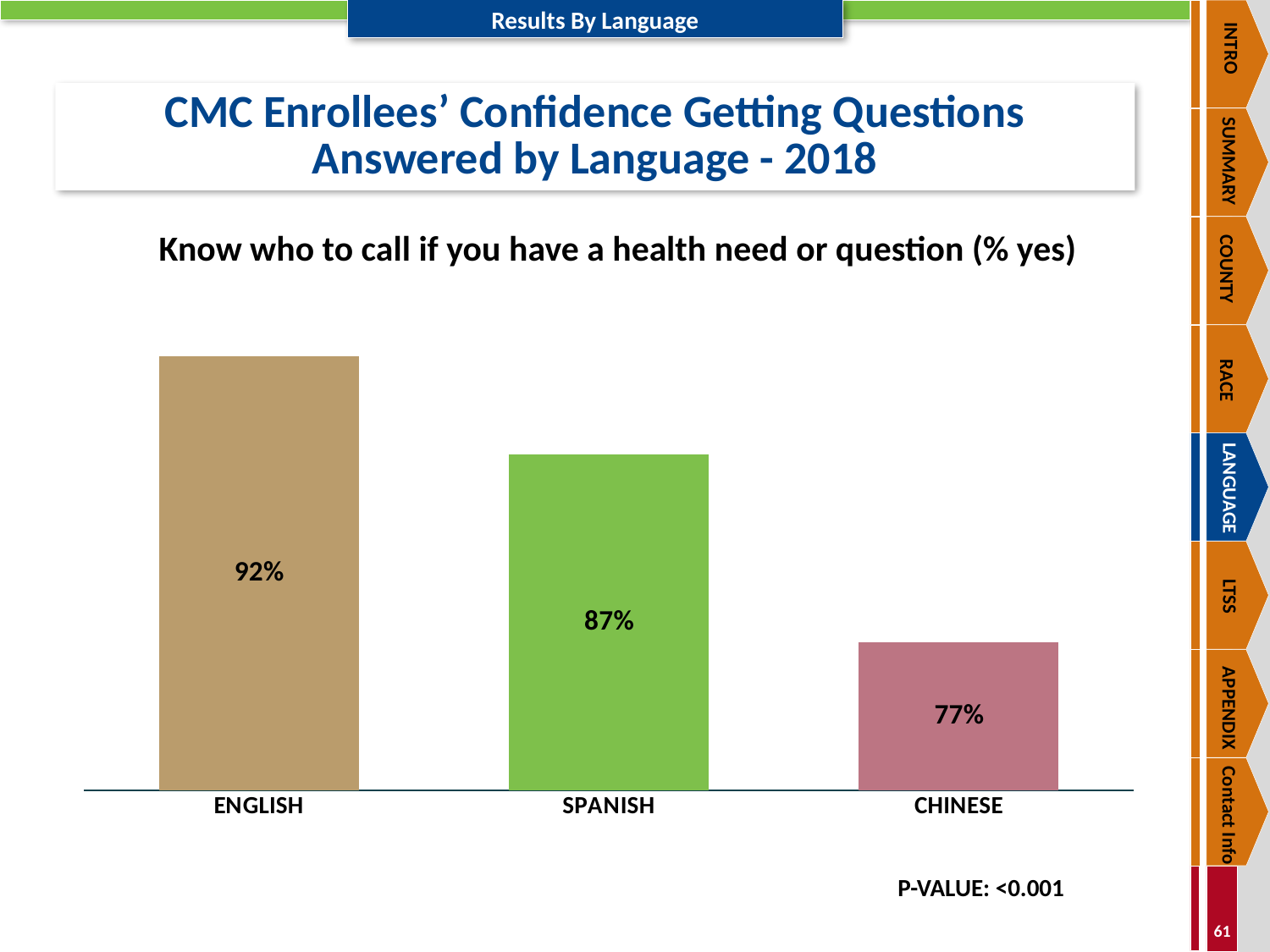
How many language groups are shown in the chart? 3 Which language group has the lowest percentage? Chinese What p-value is reported on the slide? <0.001 What is the difference in percentage points between Spanish and Chinese? 10 What is the value shown for Spanish? 87% What is the value shown for Chinese? 77% What percentage of English-speaking CMC enrollees said they know who to call if they have a health need or question? 92% Which language group has the highest percentage? English What kind of chart is shown on the slide? Bar chart What is the difference in percentage points between English and Chinese? 15 Do the values rise or fall moving from English to Chinese along the x axis? Fall Which is larger, the value for Spanish or the value for Chinese? Spanish